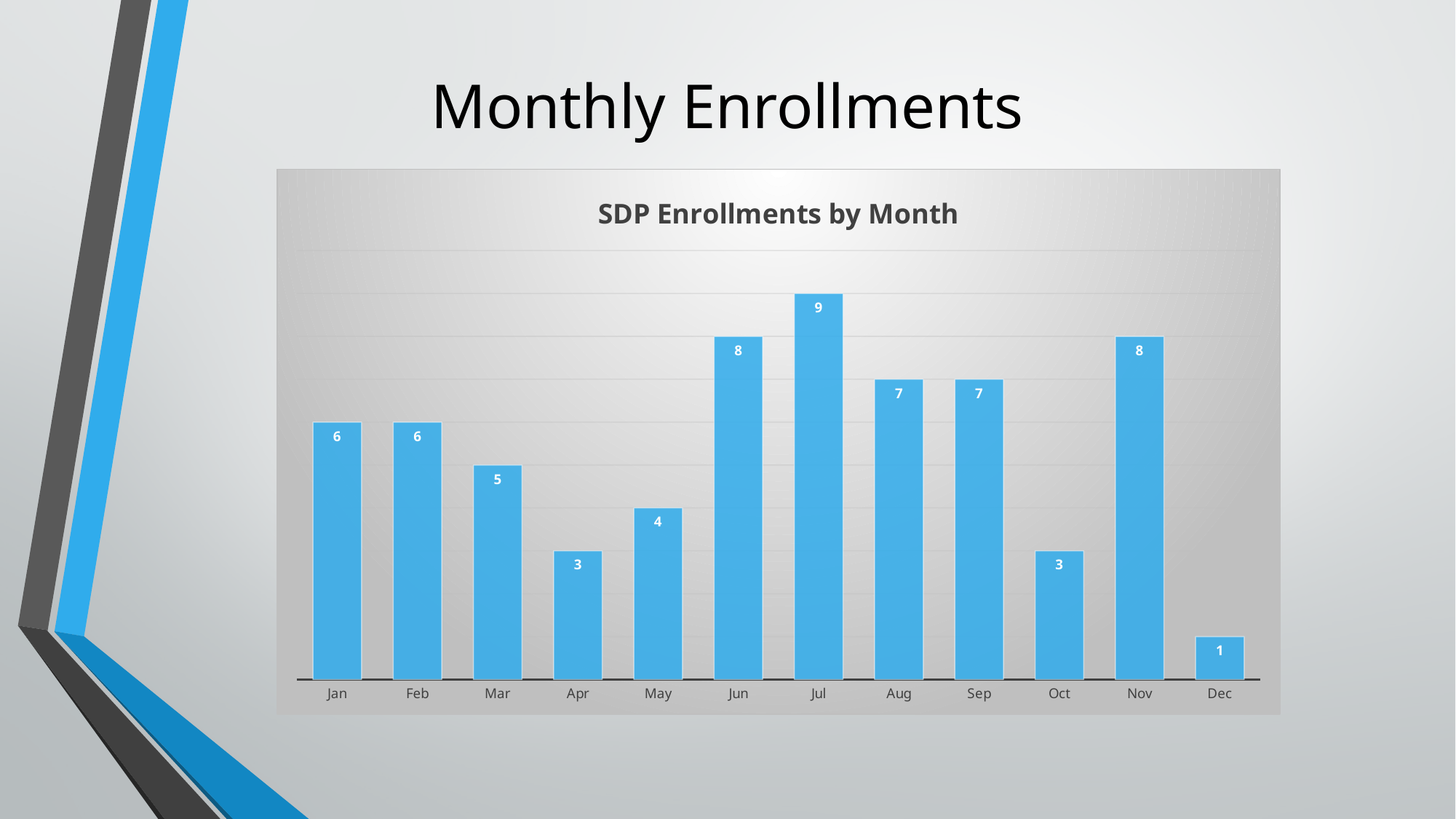
What is the value for Jul? 9 Which month has the lowest value? Dec Which is larger, the value for Mar or the value for Oct? Mar What is the difference between the values for Jul and Dec? 8 What kind of chart is this? bar chart What is the difference between the values for Jun and May? 4 What is the value for Nov? 8 What is the value for Apr? 3 Which month has the highest value? Jul Do the values rise or fall from Apr to Jul? rise What is the title of the chart? SDP Enrollments by Month How many months are shown on the x axis? 12